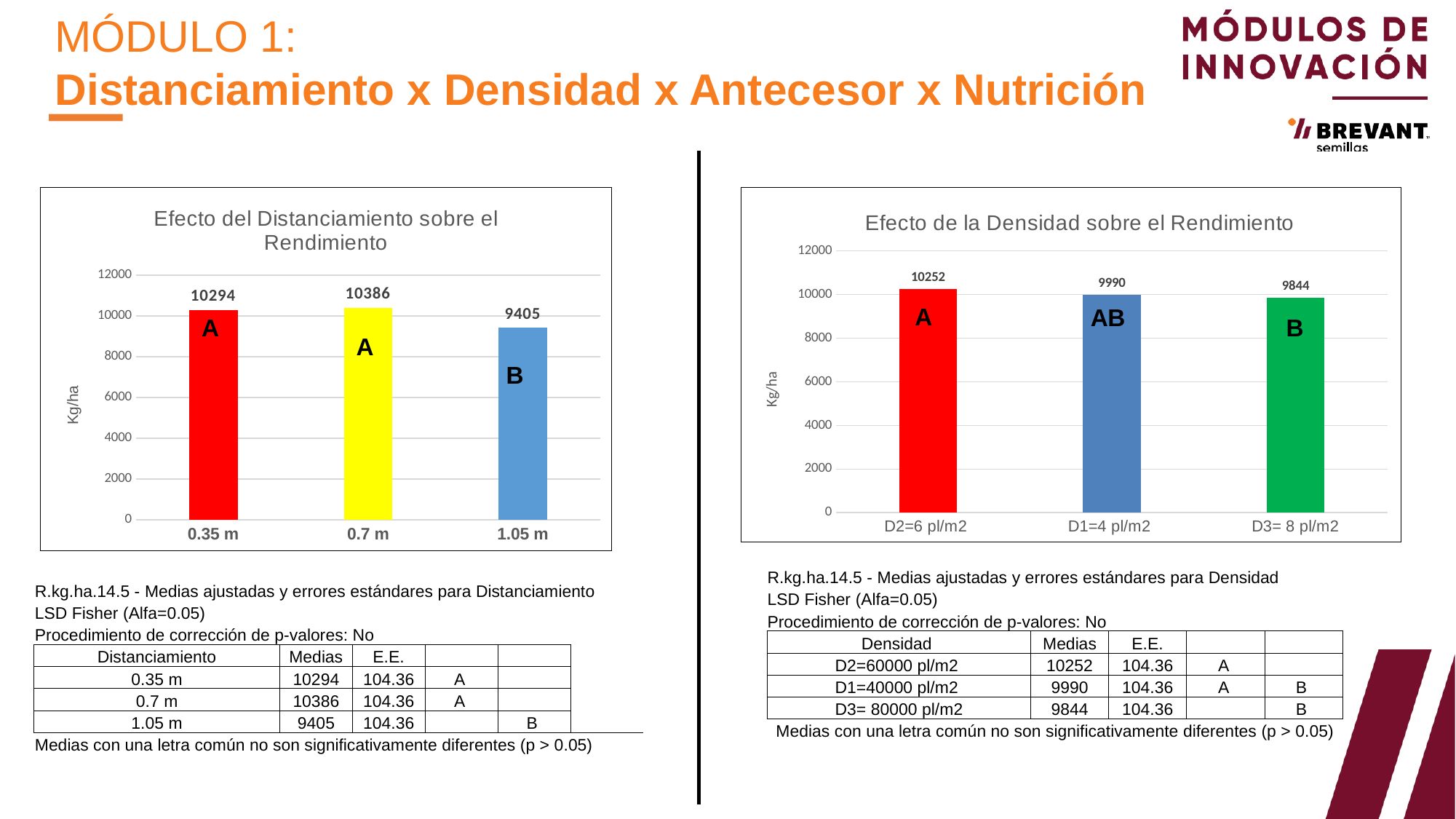
What kind of chart is 'Efecto de la Densidad sobre el Rendimiento'? bar chart In the chart 'Efecto del Distanciamiento sobre el Rendimiento', what is the value for 0.7 m? 10386 In the chart 'Efecto de la Densidad sobre el Rendimiento', which category has the highest value? D2=6 pl/m2 In the chart 'Efecto de la Densidad sobre el Rendimiento', what is the difference between the values for D2=6 pl/m2 and D1=4 pl/m2? 262 In the chart 'Efecto de la Densidad sobre el Rendimiento', what is the y-axis label? Kg/ha In the chart 'Efecto del Distanciamiento sobre el Rendimiento', what colour is the bar for 0.7 m? yellow In the chart 'Efecto de la Densidad sobre el Rendimiento', do the values rise or fall from left to right along the x axis? fall In the chart 'Efecto del Distanciamiento sobre el Rendimiento', which category has the lowest value? 1.05 m In the chart 'Efecto del Distanciamiento sobre el Rendimiento', what is the difference between the values for 0.7 m and 1.05 m? 981 In the chart 'Efecto del Distanciamiento sobre el Rendimiento', is the value for 1.05 m greater or less than 10000? less In the chart 'Efecto del Distanciamiento sobre el Rendimiento', how many categories are plotted? 3 In the chart 'Efecto de la Densidad sobre el Rendimiento', what is the value for D3= 8 pl/m2? 9844